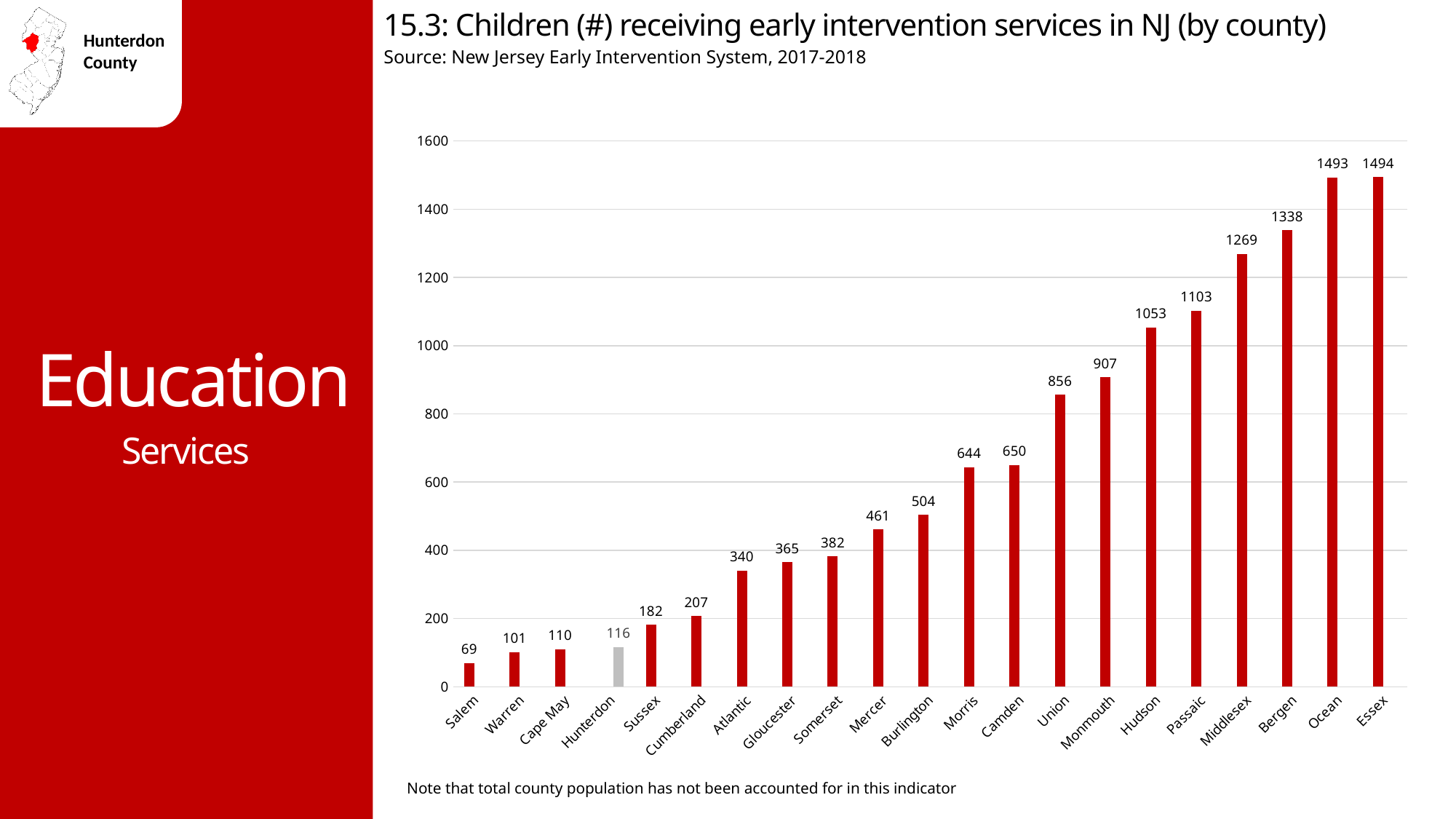
Is the value for Passaic greater or less than 1000? greater Which county has a higher value, Camden or Hudson? Hudson Which county has the lowest number of children receiving early intervention services? Salem How many counties are shown on the chart? 21 How many children received early intervention services in Hunterdon County? 116 What type of chart is shown on the slide? Bar chart What is the difference between the values for Sussex and Hunterdon? 66 What is the value shown for Mercer County? 461 Which county has a higher value, Union or Monmouth? Monmouth Which county's bar is shown in grey rather than red? Hunterdon What is the value shown for Bergen County? 1338 What is the difference between the values for Bergen and Middlesex? 69